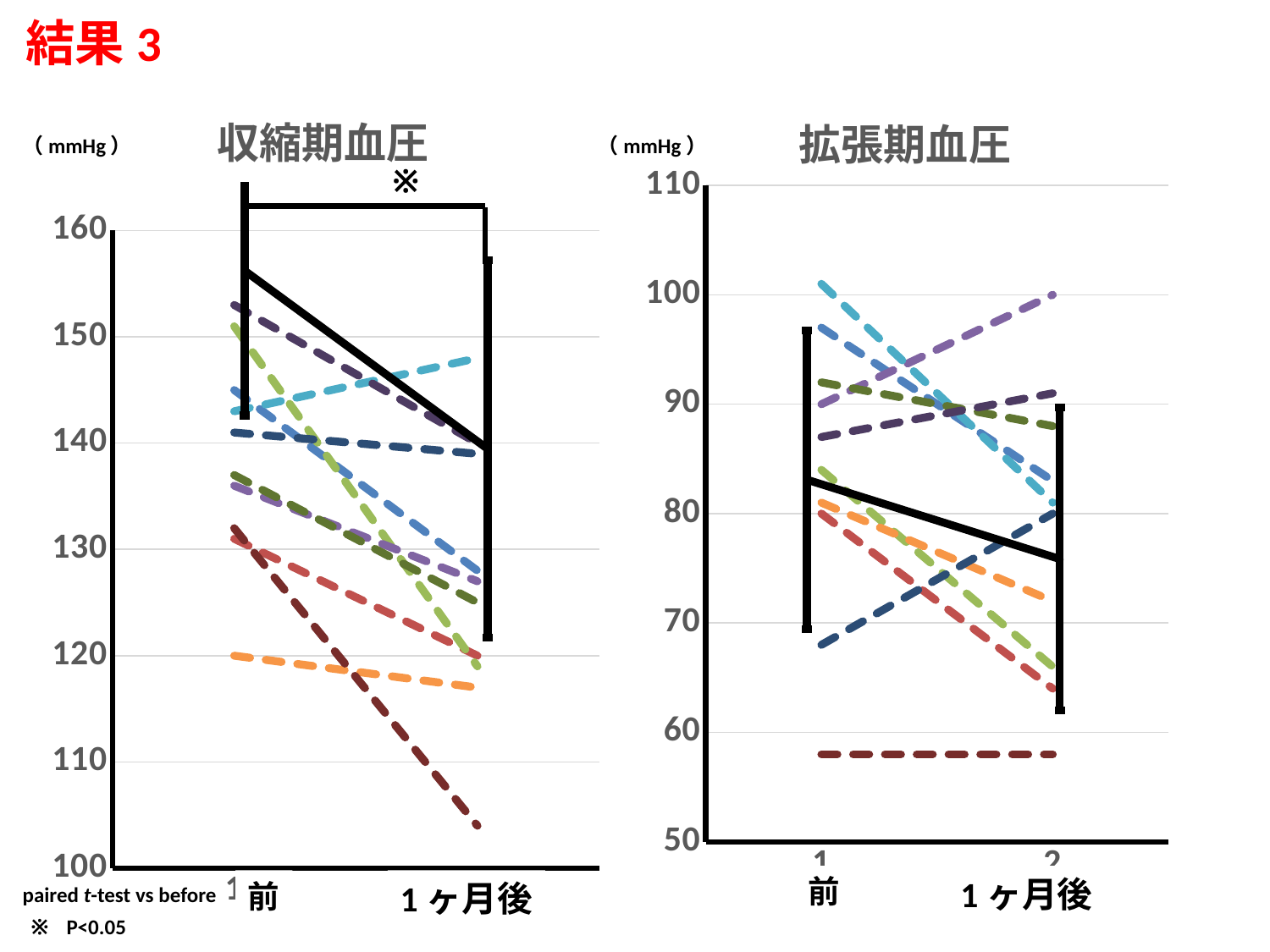
In the 拡張期血圧 chart, is the flat dark red dashed line greater or less than 60? less In the 拡張期血圧 chart, does the thick black line rise or fall from 前 to 1ヶ月後? fall What kind of chart is the 収縮期血圧 chart? line chart In the 収縮期血圧 chart, does the thick black line rise or fall from 前 to 1ヶ月後? fall In the 収縮期血圧 chart, is the lowest dashed line at 1ヶ月後 greater or less than 110? less In the 収縮期血圧 chart, is the value of the thick black line at 前 greater or less than 150? greater What unit is shown for the y axis of both charts? mmHg Which chart is marked with the ※ significance symbol (P<0.05)? 収縮期血圧 How many categories are on the x axis of the 拡張期血圧 chart? 2